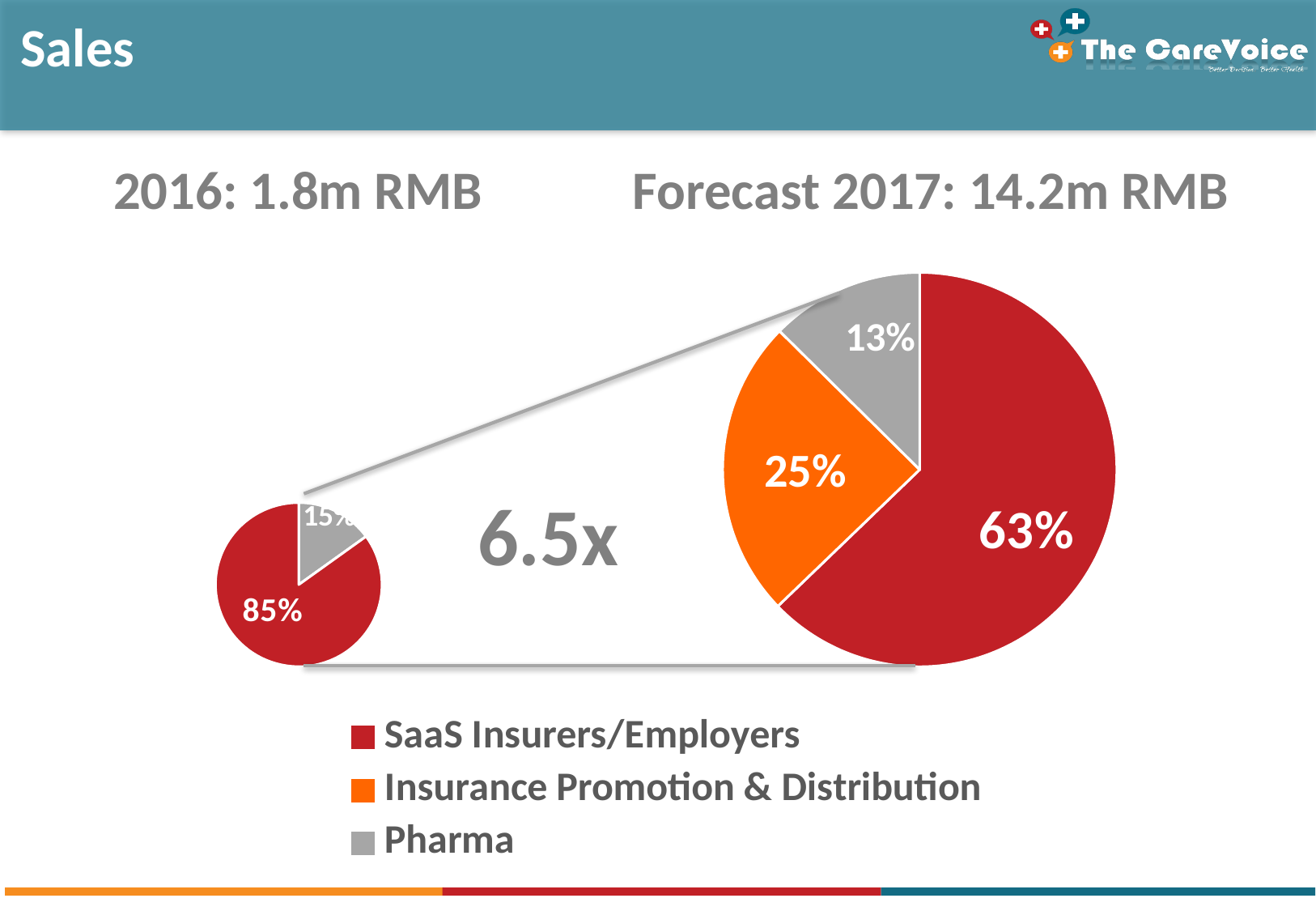
In the Forecast 2017 pie chart, what share of sales comes from SaaS Insurers/Employers? 63% In the Forecast 2017 pie chart, which segment is the smallest? Pharma In the Forecast 2017 pie chart, which segment is the largest? SaaS Insurers/Employers What type of chart is used to show the 2016 and Forecast 2017 sales breakdown? Pie chart What colour represents Pharma in the pie charts? Gray In the Forecast 2017 pie chart, which is larger: Insurance Promotion & Distribution or Pharma? Insurance Promotion & Distribution In the Forecast 2017 pie chart, what share of sales comes from Pharma? 13% In the Forecast 2017 pie chart, what is the difference in percentage points between SaaS Insurers/Employers and Insurance Promotion & Distribution? 38 How many entries does the legend list? 3 In the Forecast 2017 pie chart, what share of sales comes from Insurance Promotion & Distribution? 25% How many segments does the Forecast 2017 pie chart have? 3